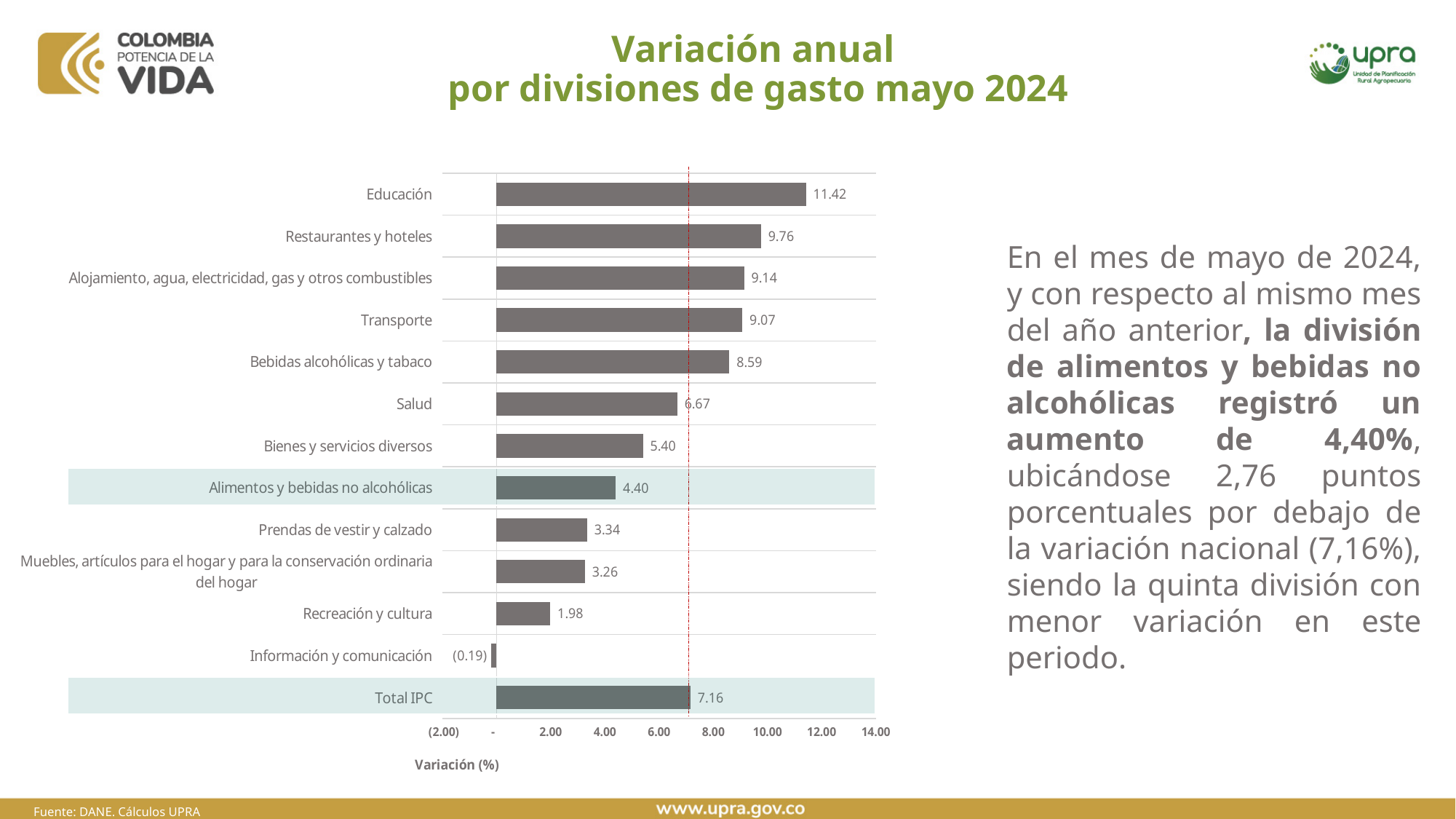
How many bars are plotted in the chart? 13 What value is shown for Información y comunicación? (0.19) What is the label of the horizontal axis? Variación (%) What is the difference between the values for Educación and Restaurantes y hoteles? 1.66 Which division has the lowest annual variation? Información y comunicación What is the annual variation for Educación? 11.42 What value is shown for Alimentos y bebidas no alcohólicas? 4.40 Which division has the highest annual variation? Educación What is the difference between Total IPC and Alimentos y bebidas no alcohólicas? 2.76 What type of chart is shown on the slide? Bar chart What is the value of the Total IPC bar? 7.16 Which is larger, the value for Salud or the value for Bienes y servicios diversos? Salud